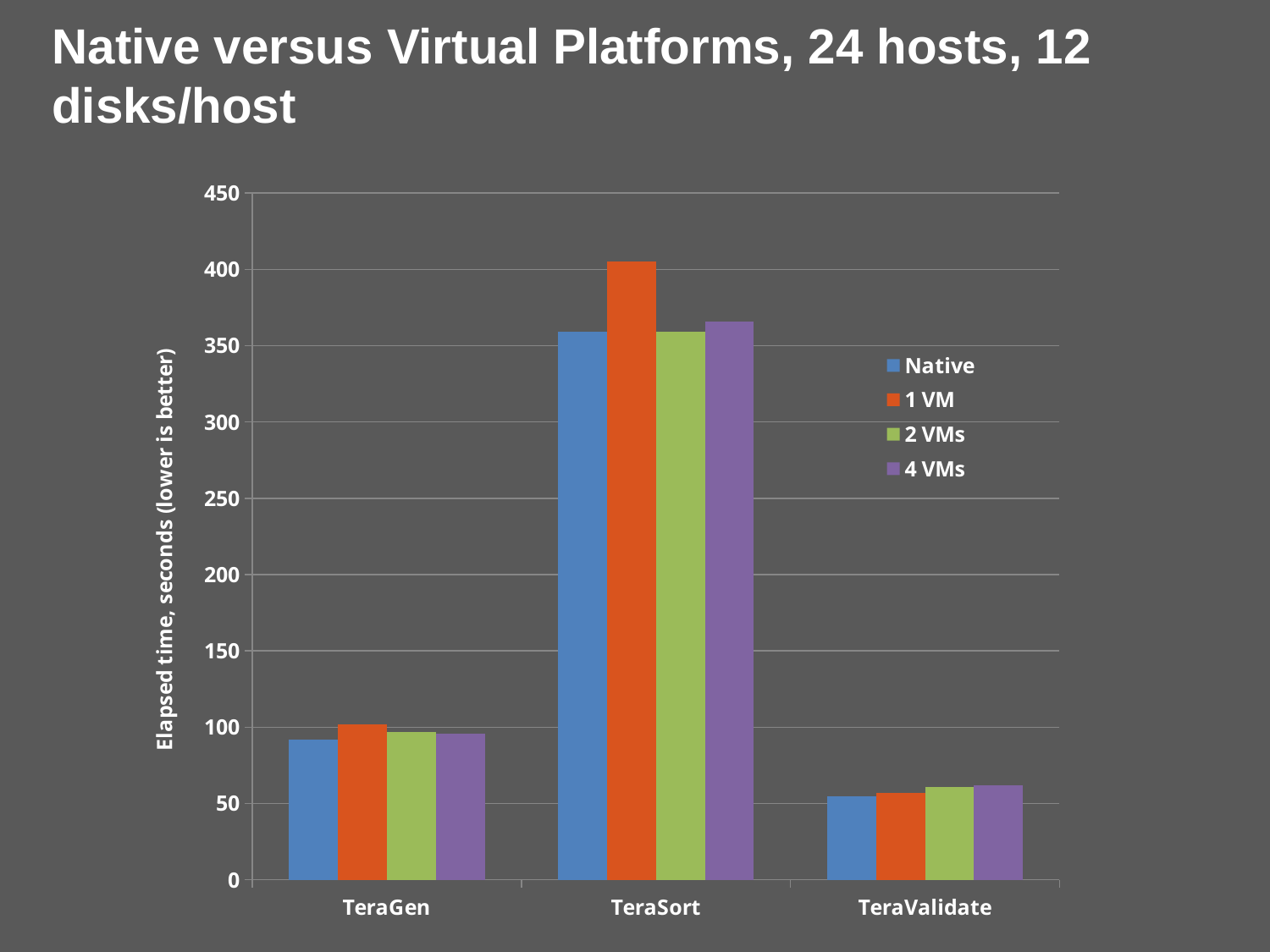
Is the value for 1 VM in TeraSort greater or less than 400? greater Which category has the highest elapsed times overall? TeraSort Is the value for Native in TeraSort greater or less than 400? less Is the value for Native in TeraGen greater or less than 100? less For TeraValidate, which is larger: the Native value or the 4 VMs value? 4 VMs How many series does the legend list? 4 What is the label of the y axis? Elapsed time, seconds (lower is better) Which series has the highest value for TeraSort? 1 VM What kind of chart is shown on the slide? bar chart How many categories are shown on the x axis? 3 Which category has the lowest elapsed times overall? TeraValidate For TeraSort, which is larger: the Native value or the 1 VM value? 1 VM